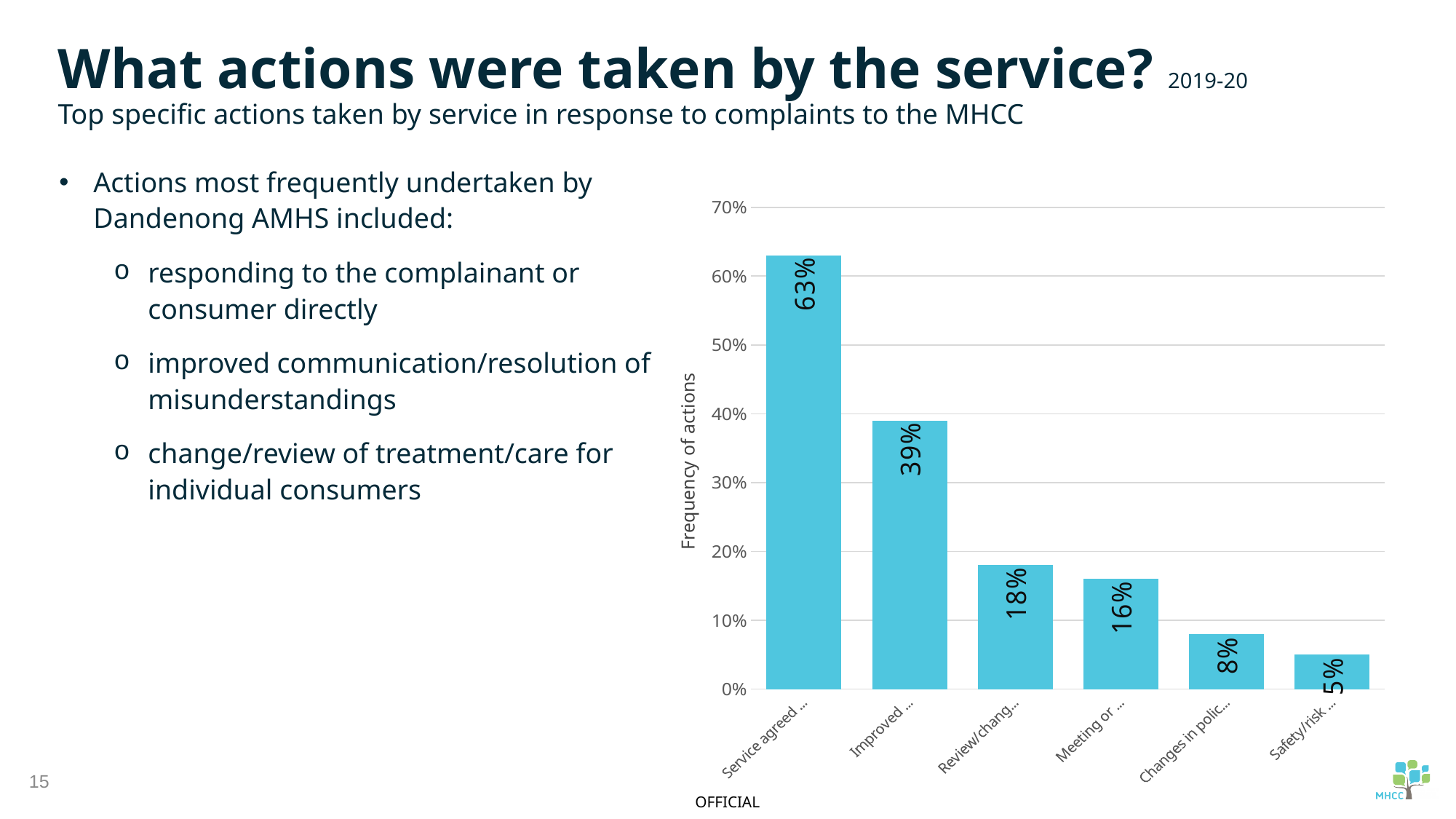
How many bars are plotted in the chart? 6 Which bar has the highest value? Service agreed ... What type of chart is shown on the slide? bar chart What is the value of the bar labelled "Meeting or ..."? 16% Do the bar values rise or fall from left to right along the x axis? fall Which bar has the lowest value? Safety/risk ... What is the value of the first bar, labelled "Service agreed ..."? 63% What is the label of the vertical axis? Frequency of actions What is the difference between the values of the "Service agreed ..." bar and the "Improved ..." bar? 24% What is the value of the bar labelled "Review/chang..."? 18% What is the value of the bar labelled "Improved ..."? 39% What is the value of the last bar, labelled "Safety/risk ..."? 5%